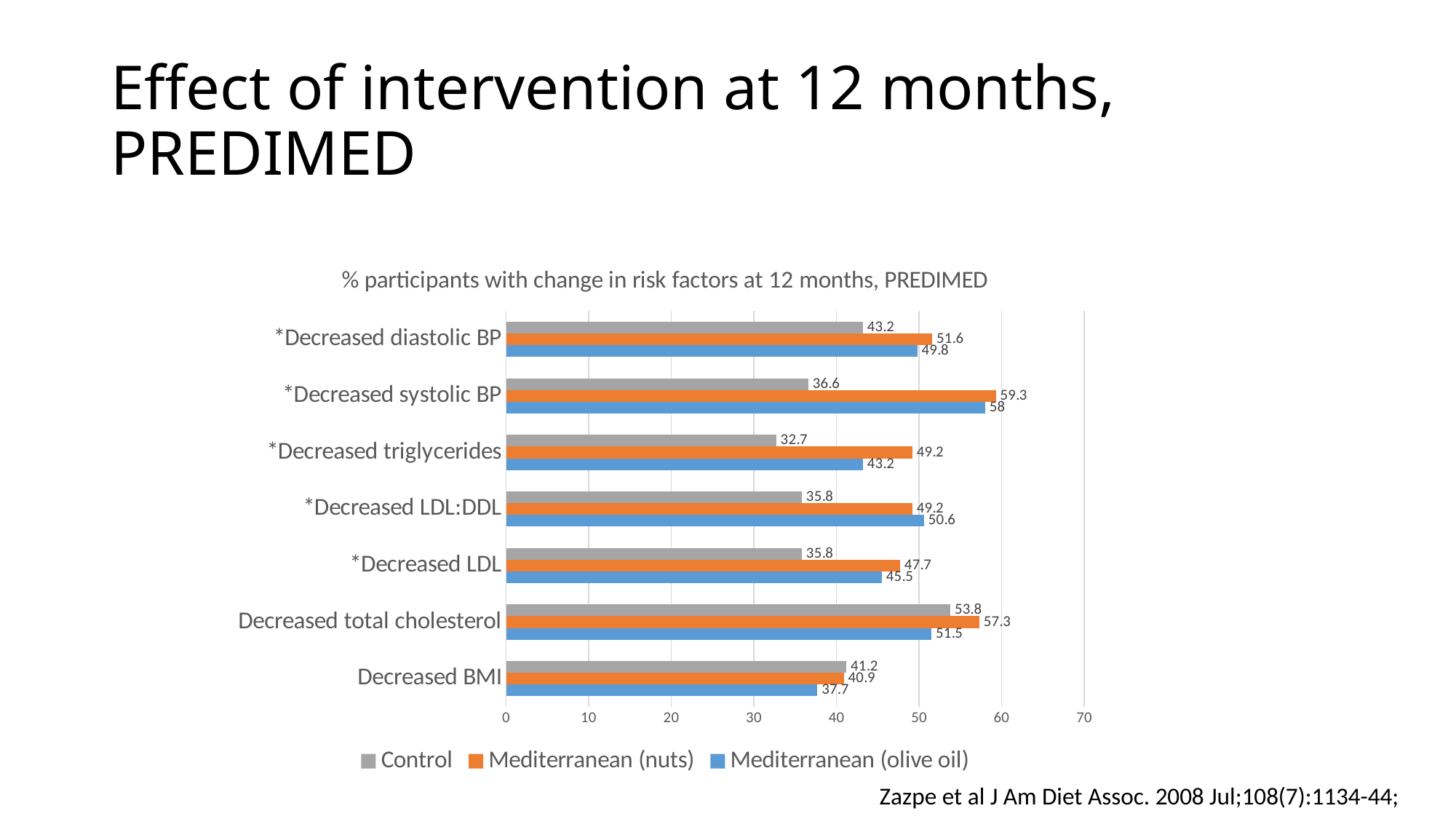
For Decreased total cholesterol, which is larger: the Control value or the Mediterranean (olive oil) value? Control What is the title of the chart? % participants with change in risk factors at 12 months, PREDIMED How many categories are shown on the y axis? 7 What is the difference between the Mediterranean (nuts) and Control values for *Decreased systolic BP? 22.7 What is the Control value for *Decreased diastolic BP? 43.2 What kind of chart is shown? Bar chart What is the Mediterranean (nuts) value for *Decreased systolic BP? 59.3 How many series does the legend list? 3 Is the Mediterranean (olive oil) value for *Decreased systolic BP greater or less than 50? greater What is the Mediterranean (olive oil) value for Decreased BMI? 37.7 Which category has the lowest Control value? *Decreased triglycerides Which category has the highest Mediterranean (nuts) value? *Decreased systolic BP